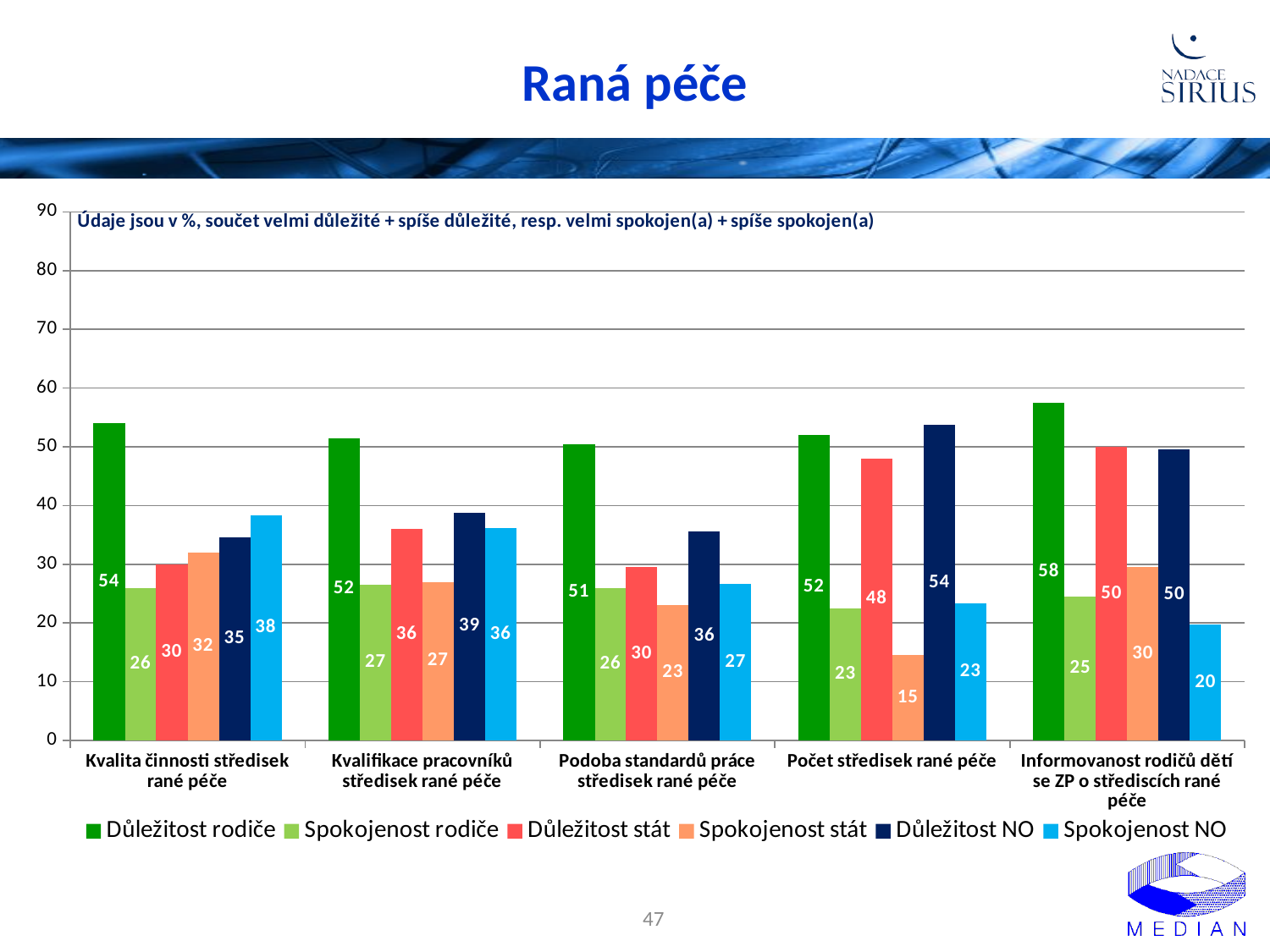
What is the value of Důležitost rodiče for Kvalita činnosti středisek rané péče? 54 How many series does the legend list? 6 Which category has the lowest value for Spokojenost NO? Informovanost rodičů dětí se ZP o střediscích rané péče Which is larger for Podoba standardů práce středisek rané péče: Důležitost NO or Spokojenost NO? Důležitost NO How many categories are shown on the x axis? 5 What is the difference between Důležitost stát and Spokojenost stát for Počet středisek rané péče? 33 Which category has the highest value for Důležitost rodiče? Informovanost rodičů dětí se ZP o střediscích rané péče Is the value of Důležitost NO for Počet středisek rané péče greater or less than 50? greater What kind of chart is shown on the slide? bar chart What is the title of the slide? Raná péče What is the value of Důležitost NO for Kvalifikace pracovníků středisek rané péče? 39 What is the value of Spokojenost stát for Počet středisek rané péče? 15